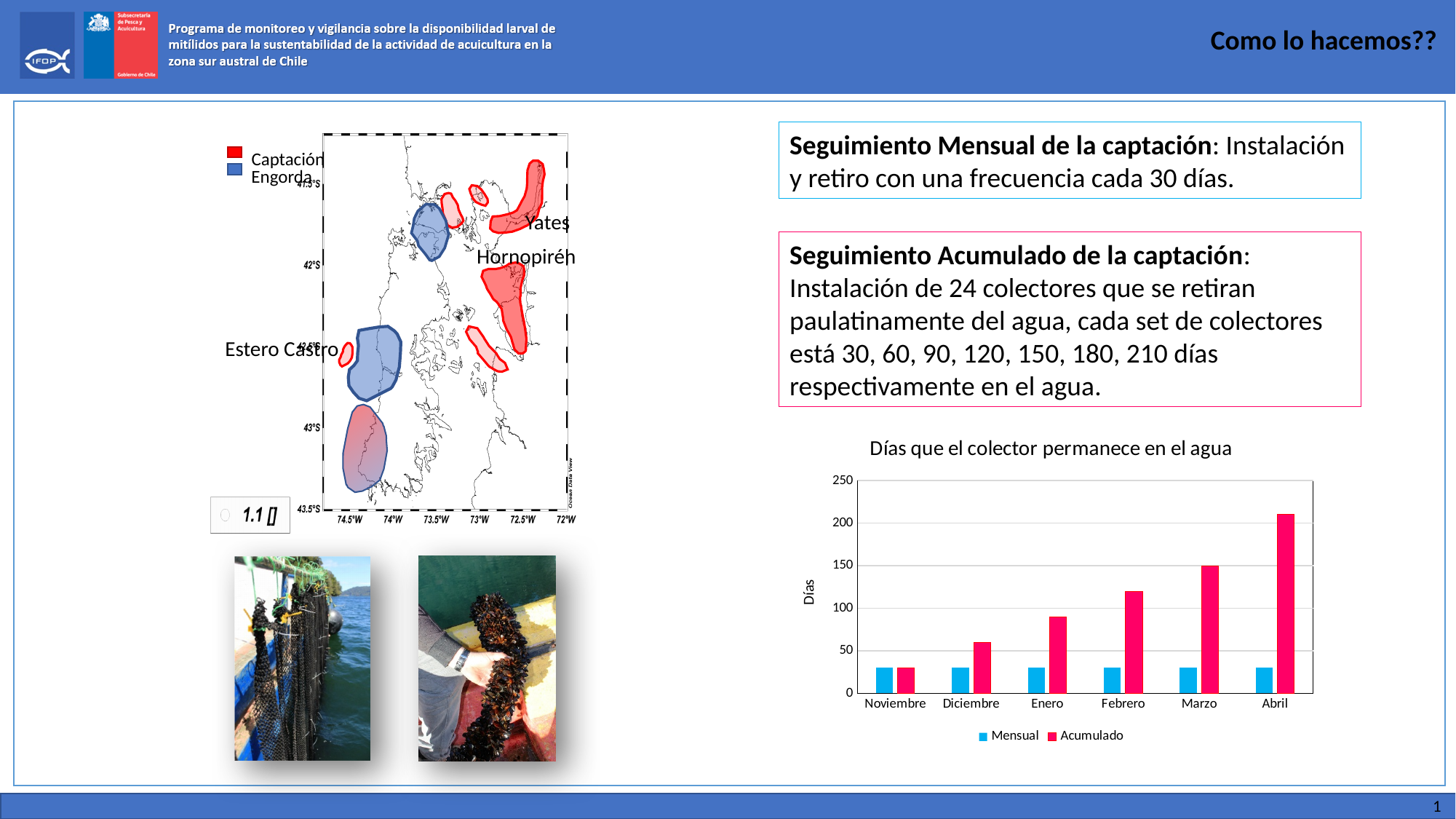
In the 'Días que el colector permanece en el agua' chart, is the Mensual value for Marzo greater or less than 50? less How many series does the legend of the 'Días que el colector permanece en el agua' chart list? 2 In the 'Días que el colector permanece en el agua' chart, which is larger for Marzo: Mensual or Acumulado? Acumulado In the 'Días que el colector permanece en el agua' chart, is the Acumulado value for Enero greater or less than 100? less In the 'Días que el colector permanece en el agua' chart, do the Acumulado values rise or fall from Noviembre to Abril? rise In the 'Días que el colector permanece en el agua' chart, is the Acumulado value for Febrero greater or less than 100? greater In the 'Días que el colector permanece en el agua' chart, which month has the highest Acumulado value? Abril What is the y-axis label of the 'Días que el colector permanece en el agua' chart? Días How many months are shown on the x axis of the 'Días que el colector permanece en el agua' chart? 6 In the 'Días que el colector permanece en el agua' chart, what colour are the Acumulado bars? red What type of chart is 'Días que el colector permanece en el agua'? bar chart